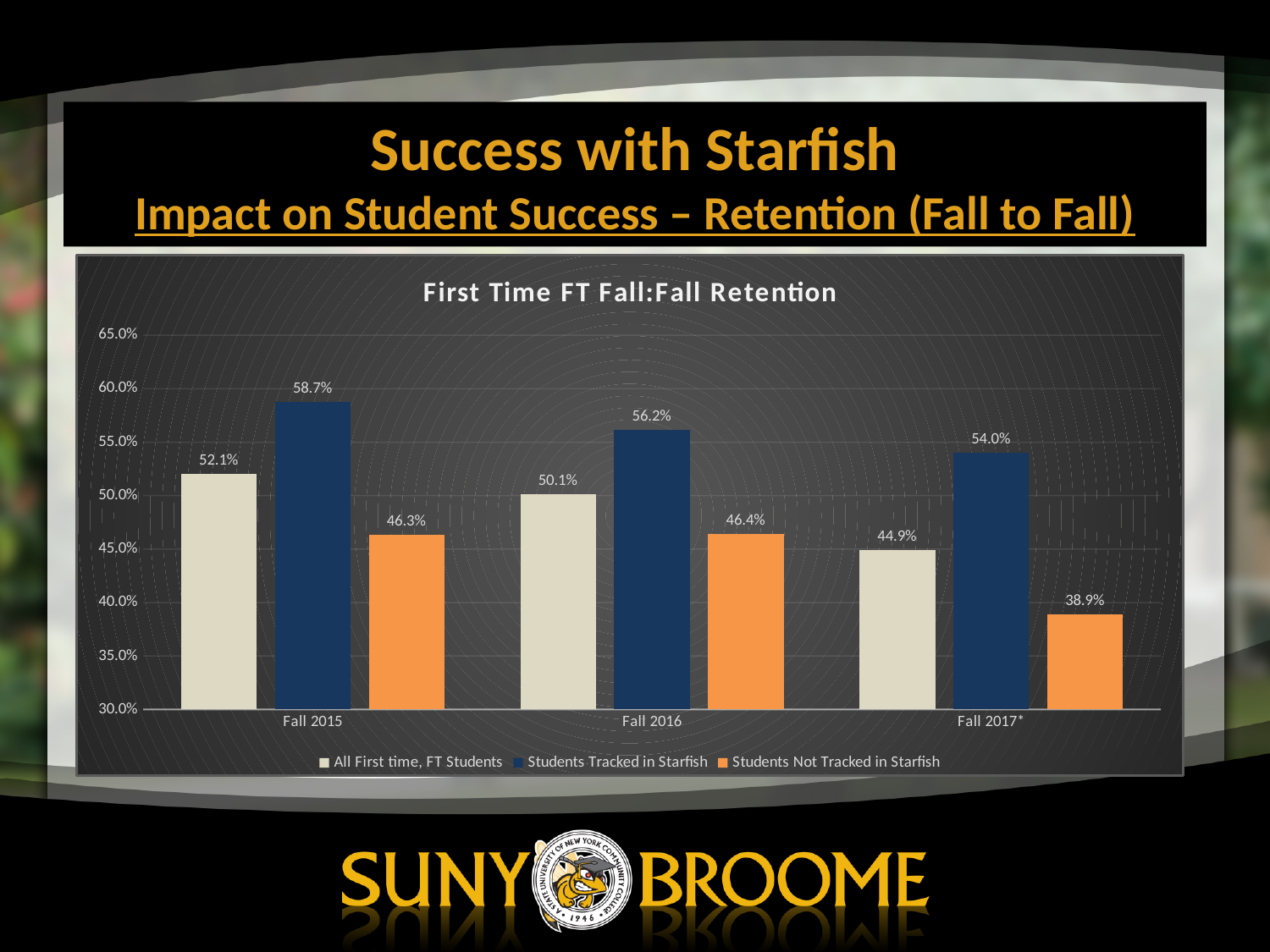
In Fall 2016, which group has the higher retention rate: Students Tracked in Starfish or Students Not Tracked in Starfish? Students Tracked in Starfish How many terms are shown on the x axis? 3 What is the retention rate for Students Not Tracked in Starfish in Fall 2017*? 38.9% Which term has the highest retention rate for Students Tracked in Starfish? Fall 2015 What is the retention rate for Students Tracked in Starfish in Fall 2015? 58.7% What is the retention rate for All First time, FT Students in Fall 2016? 50.1% What kind of chart is shown on the slide? Bar chart What is the difference between the retention rates of Students Tracked in Starfish and Students Not Tracked in Starfish in Fall 2017*? 15.1% Does the retention rate for All First time, FT Students rise or fall from Fall 2015 to Fall 2017*? Fall How many series does the legend list? 3 Which term has the lowest retention rate for Students Not Tracked in Starfish? Fall 2017* What is the difference between the retention rates of Students Tracked in Starfish and All First time, FT Students in Fall 2015? 6.6%